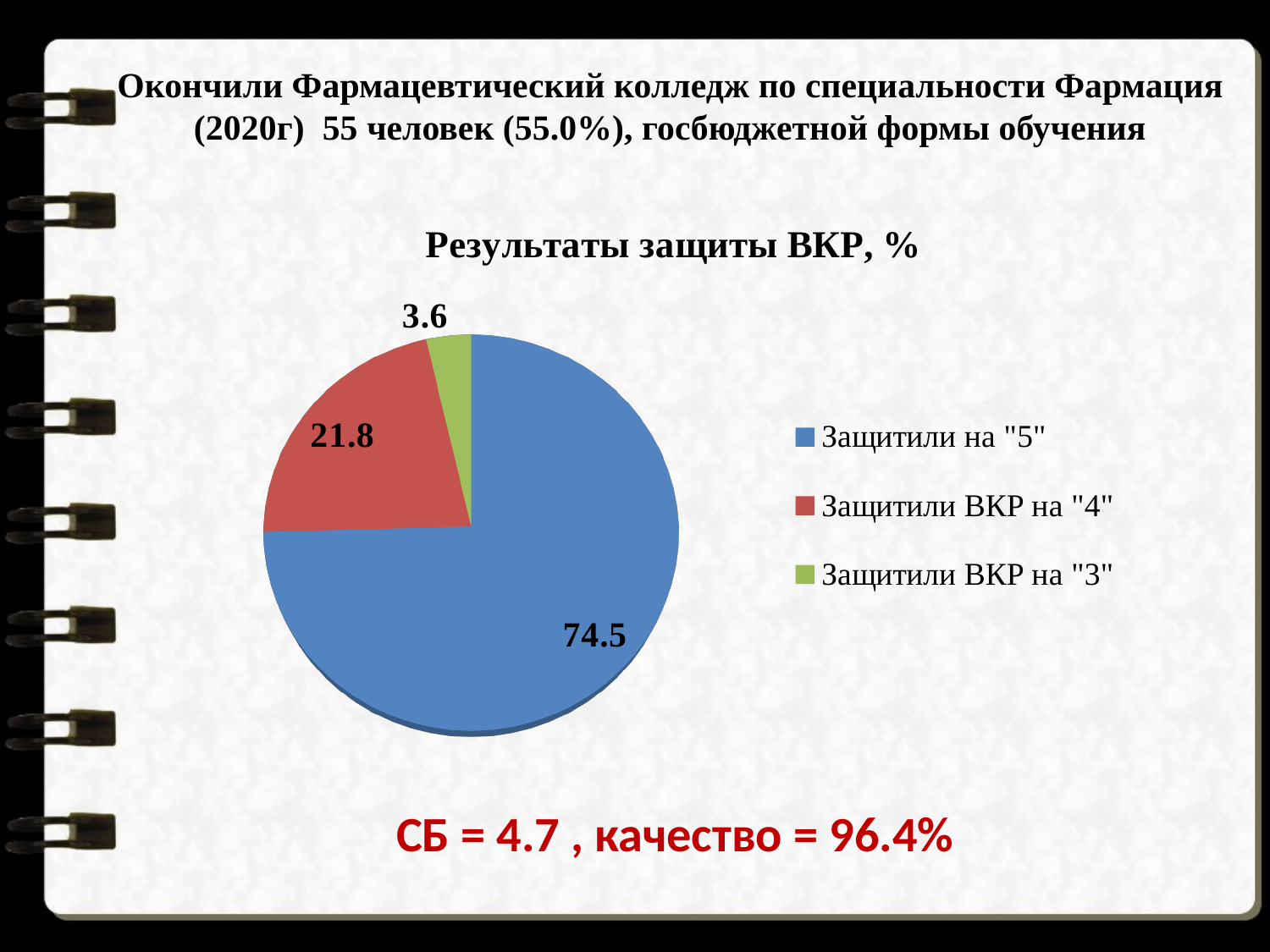
Which category has the largest slice of the pie? Защитили на "5" What is the difference between the values for 'Защитили ВКР на "4"' and 'Защитили ВКР на "3"'? 18.2 What is the difference between the values for 'Защитили на "5"' and 'Защитили ВКР на "4"'? 52.7 What type of chart is shown on the slide? pie chart Which category has the smallest slice of the pie? Защитили ВКР на "3" What value is shown for the slice 'Защитили ВКР на "3"'? 3.6 What value is shown for the slice 'Защитили на "5"'? 74.5 What colour is the slice for 'Защитили ВКР на "3"'? green What is the title of the chart? Результаты защиты ВКР, % What value is shown for the slice 'Защитили ВКР на "4"'? 21.8 Which is larger: the value for 'Защитили ВКР на "4"' or for 'Защитили ВКР на "3"'? Защитили ВКР на "4" How many slices does the pie chart have? 3